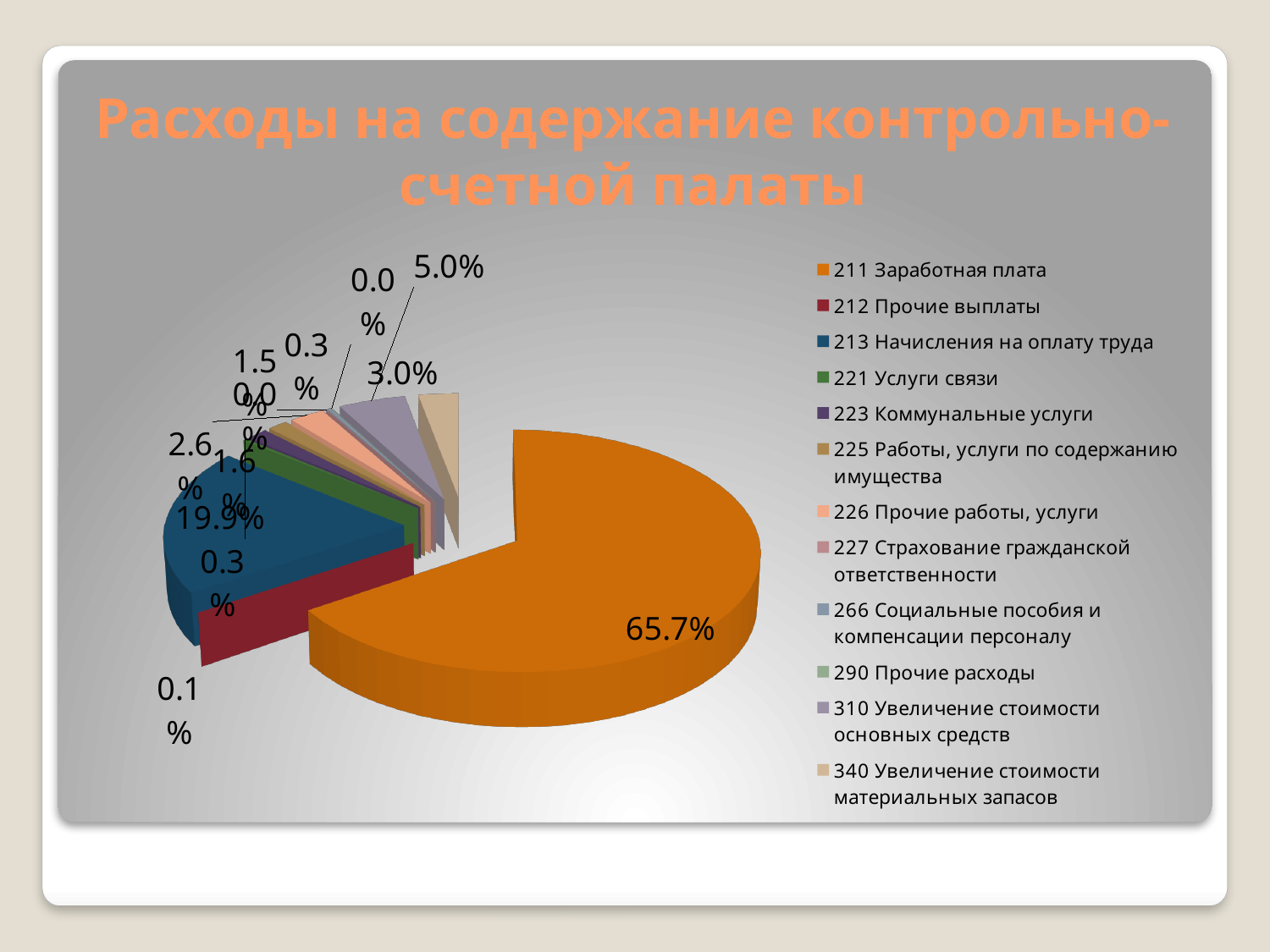
What colour is the slice for 211 Заработная плата? Orange Is the share for 213 Начисления на оплату труда greater or less than 25%? less How many data labels on the chart read 0.0%? 2 What type of chart is shown on the slide? Pie chart How many categories does the legend list? 12 What share of the pie does 213 Начисления на оплату труда have? 19.9% Is the share for 211 Заработная плата greater or less than 50%? greater Which category has the largest share of the pie? 211 Заработная плата Which is larger, the share of 211 Заработная плата or the share of 213 Начисления на оплату труда? 211 Заработная плата What is the title of the chart? Расходы на содержание контрольно-счетной палаты What share of the pie does 211 Заработная плата have? 65.7% What is the difference in percentage points between the shares of 211 Заработная плата and 213 Начисления на оплату труда? 45.8